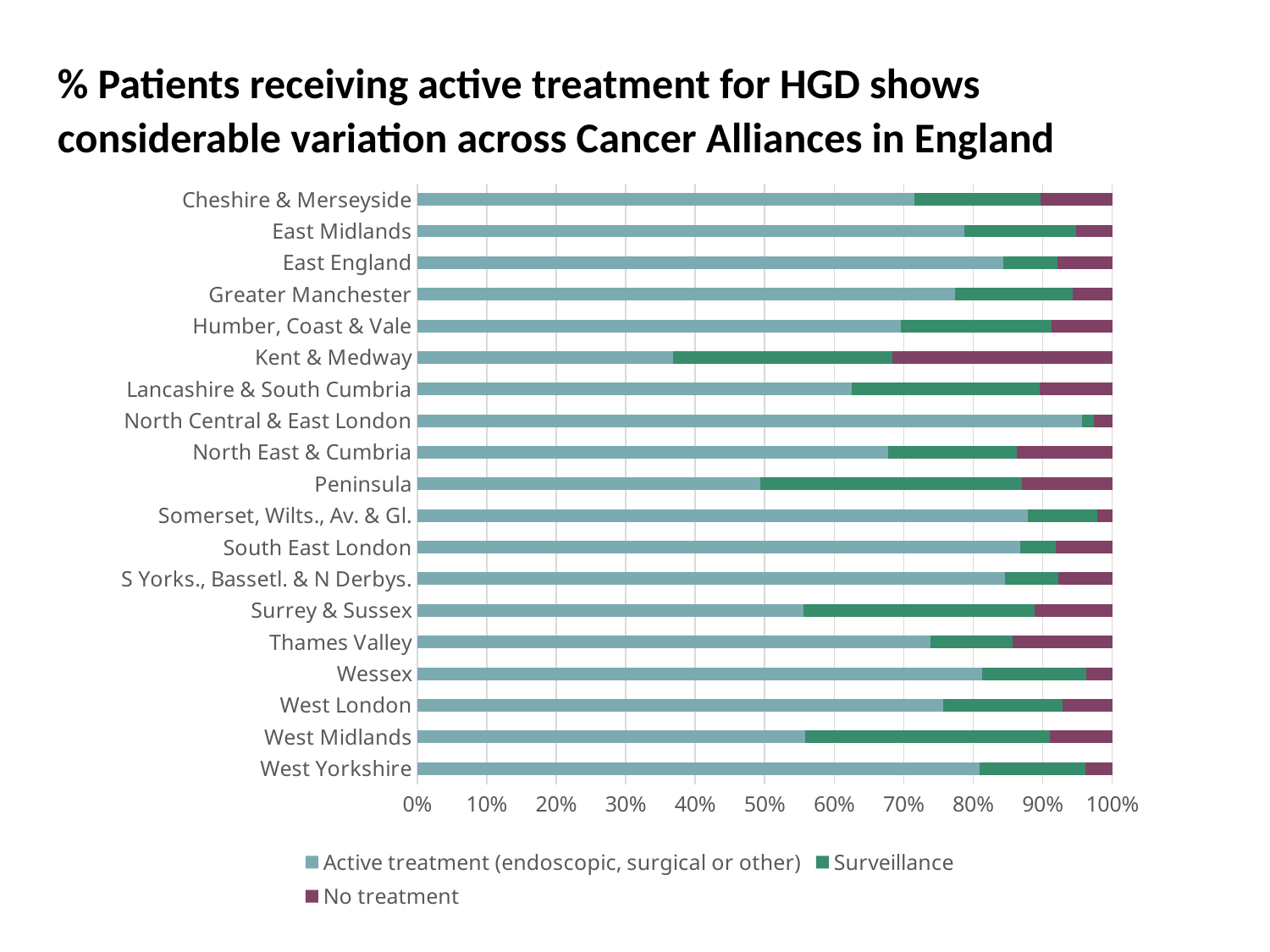
What kind of chart is shown on the slide? Stacked bar chart Which has a larger active treatment share, East Midlands or Humber, Coast & Vale? East Midlands Which Cancer Alliance has the lowest share of patients receiving active treatment? Kent & Medway Which series is shown in the darkest (purple) colour in the legend? No treatment How many Cancer Alliances (categories) are plotted on the chart? 19 Which Cancer Alliance has the highest share of patients receiving active treatment? North Central & East London Which Cancer Alliance has the largest 'No treatment' share? Kent & Medway How many series does the legend list? 3 Is the active treatment share for East England greater or less than 80%? greater Is the active treatment share for Peninsula greater or less than 60%? less Is the active treatment share for North Central & East London greater or less than 90%? greater